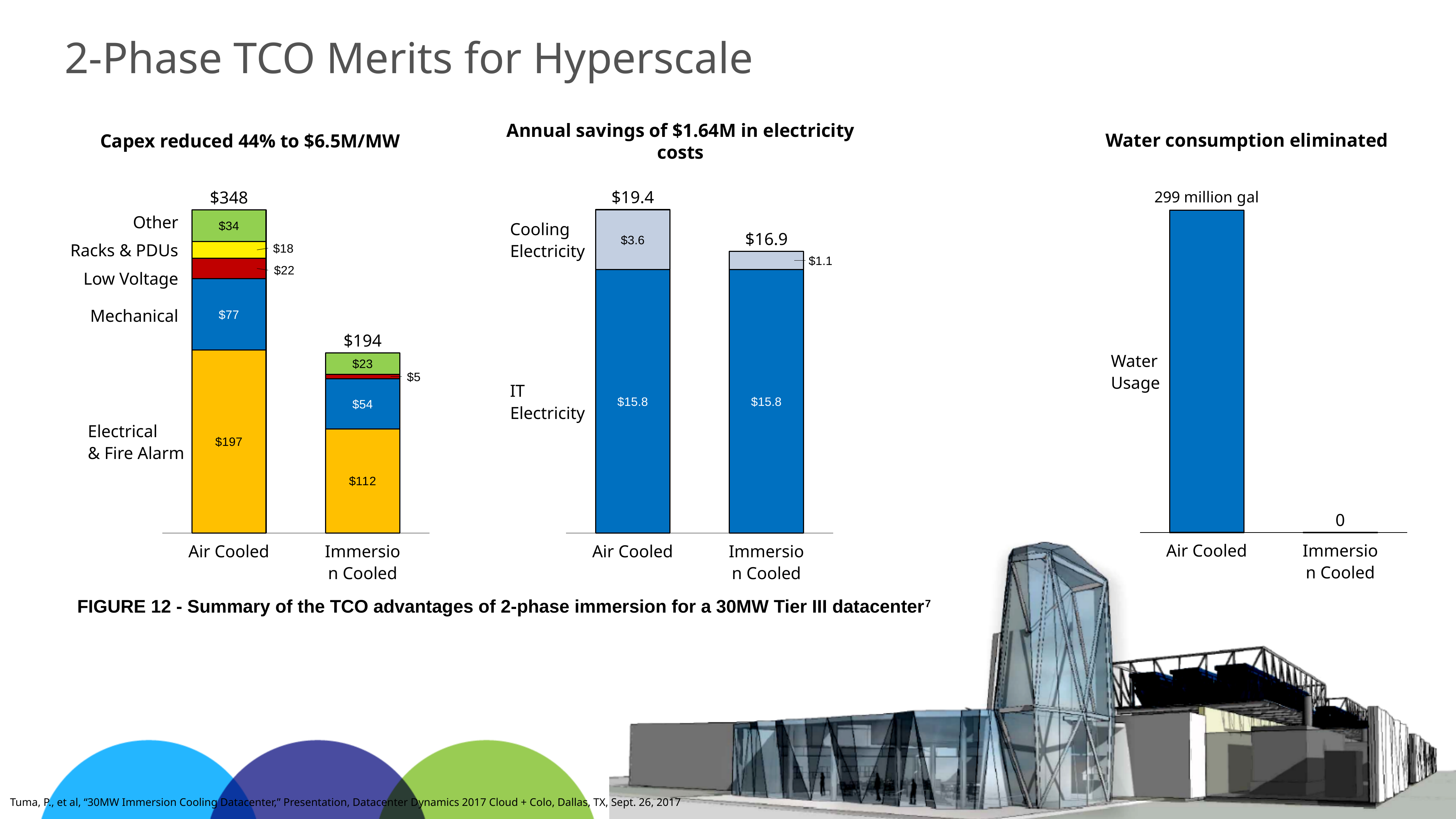
In the 'Capex reduced 44% to $6.5M/MW' chart, what is the Mechanical value for Air Cooled? $77 In the 'Capex reduced 44% to $6.5M/MW' chart, what is the difference between the Air Cooled and Immersion Cooled totals? $154 In the 'Annual savings of $1.64M in electricity costs' chart, what is the total for the Immersion Cooled bar? $16.9 In the 'Capex reduced 44% to $6.5M/MW' chart, what is the total for the Air Cooled bar? $348 In the 'Annual savings of $1.64M in electricity costs' chart, which bar has the higher total, Air Cooled or Immersion Cooled? Air Cooled In the 'Capex reduced 44% to $6.5M/MW' chart, which segment is the largest in the Air Cooled bar? Electrical & Fire Alarm What kind of chart is the 'Water consumption eliminated' chart? Bar chart In the 'Annual savings of $1.64M in electricity costs' chart, what is the Cooling Electricity value for Air Cooled? $3.6 In the 'Water consumption eliminated' chart, what is the Water Usage value for Immersion Cooled? 0 In the 'Capex reduced 44% to $6.5M/MW' chart, what is the Electrical & Fire Alarm value for Immersion Cooled? $112 In the 'Annual savings of $1.64M in electricity costs' chart, what is the Cooling Electricity value for Immersion Cooled? $1.1 In the 'Water consumption eliminated' chart, what is the Water Usage value for Air Cooled? 299 million gal